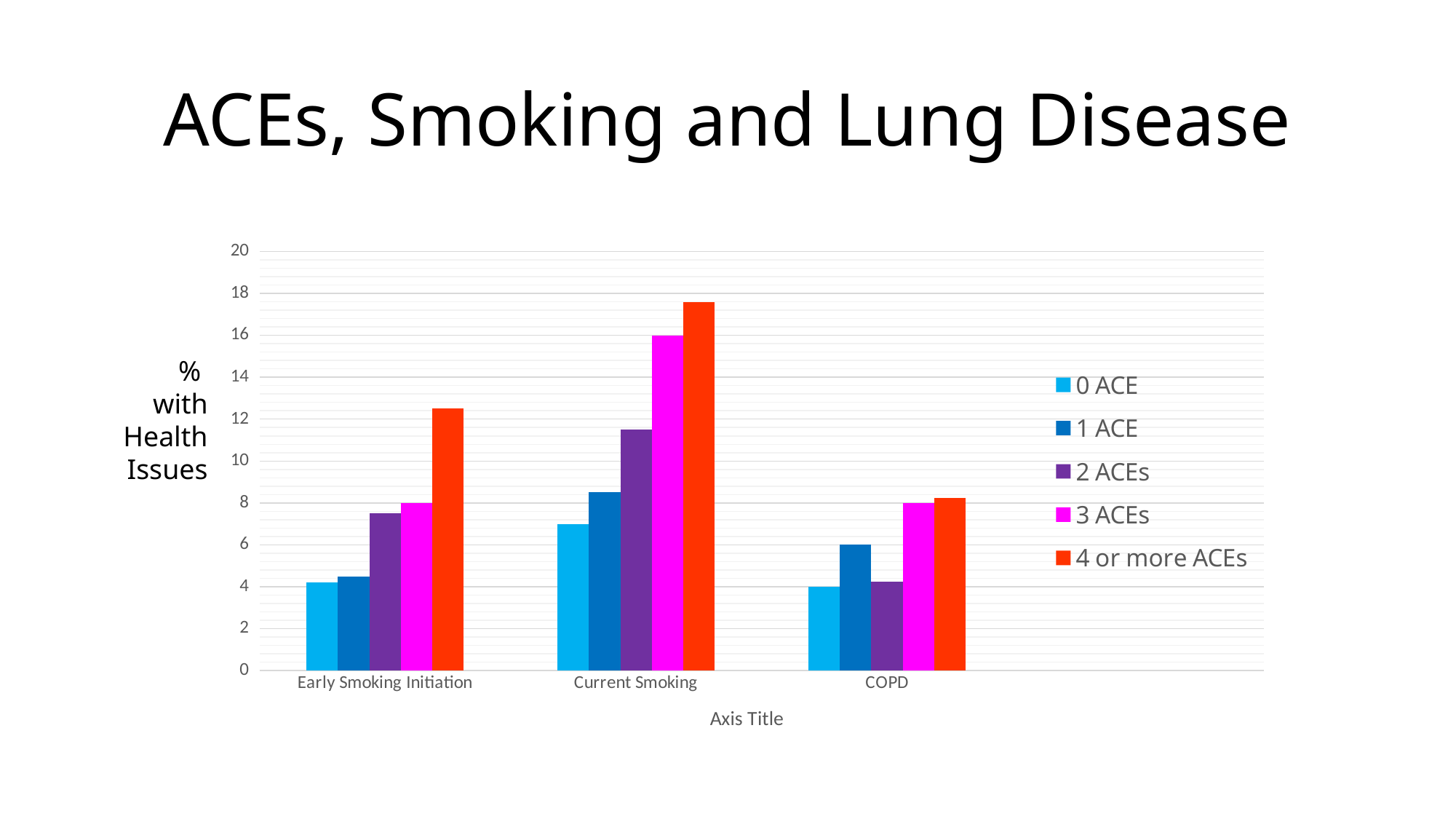
What is the title of the chart? ACEs, Smoking and Lung Disease What kind of chart is shown on the slide? Bar chart Within the Current Smoking category, do the values rise or fall from 0 ACE to 4 or more ACEs? rise How many categories are shown on the x axis? 3 For which category is the 4 or more ACEs bar the tallest? Current Smoking Is the value for 0 ACE in Current Smoking greater or less than 8? less Which series has the highest value for Current Smoking? 4 or more ACEs Which series has the lowest value for Current Smoking? 0 ACE For COPD, which is larger: the value for 1 ACE or the value for 2 ACEs? 1 ACE How many series does the legend list? 5 Is the value for 4 or more ACEs in Current Smoking greater or less than 16? greater What is the label on the vertical axis? % with Health Issues